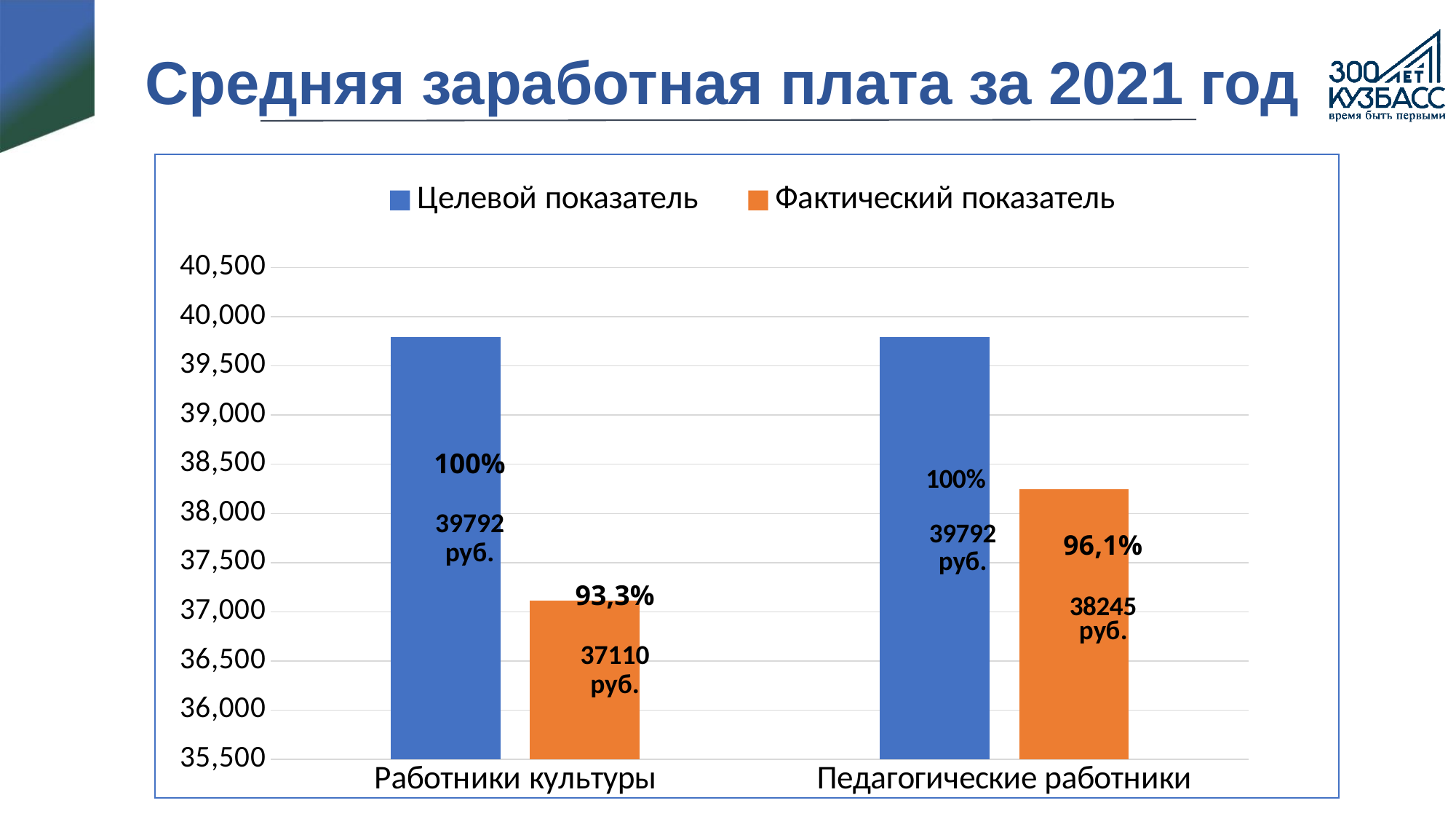
What kind of chart is shown on the slide? Bar chart What is the difference between the Целевой показатель and the Фактический показатель for Работники культуры? 2682 руб. What is the Фактический показатель value for Педагогические работники? 38245 руб. Which category has the lower Фактический показатель value? Работники культуры What percentage of the target is shown on the Фактический показатель bar for Педагогические работники? 96,1% Is the Фактический показатель for Педагогические работники greater or less than 38,000? greater What is the Фактический показатель value for Работники культуры? 37110 руб. What is the difference between the Фактический показатель values for Педагогические работники and Работники культуры? 1135 руб. How many series does the legend list? 2 What percentage of the target is shown on the Фактический показатель bar for Работники культуры? 93,3% Which category has the higher Фактический показатель value? Педагогические работники What is the Целевой показатель value for Педагогические работники? 39792 руб.